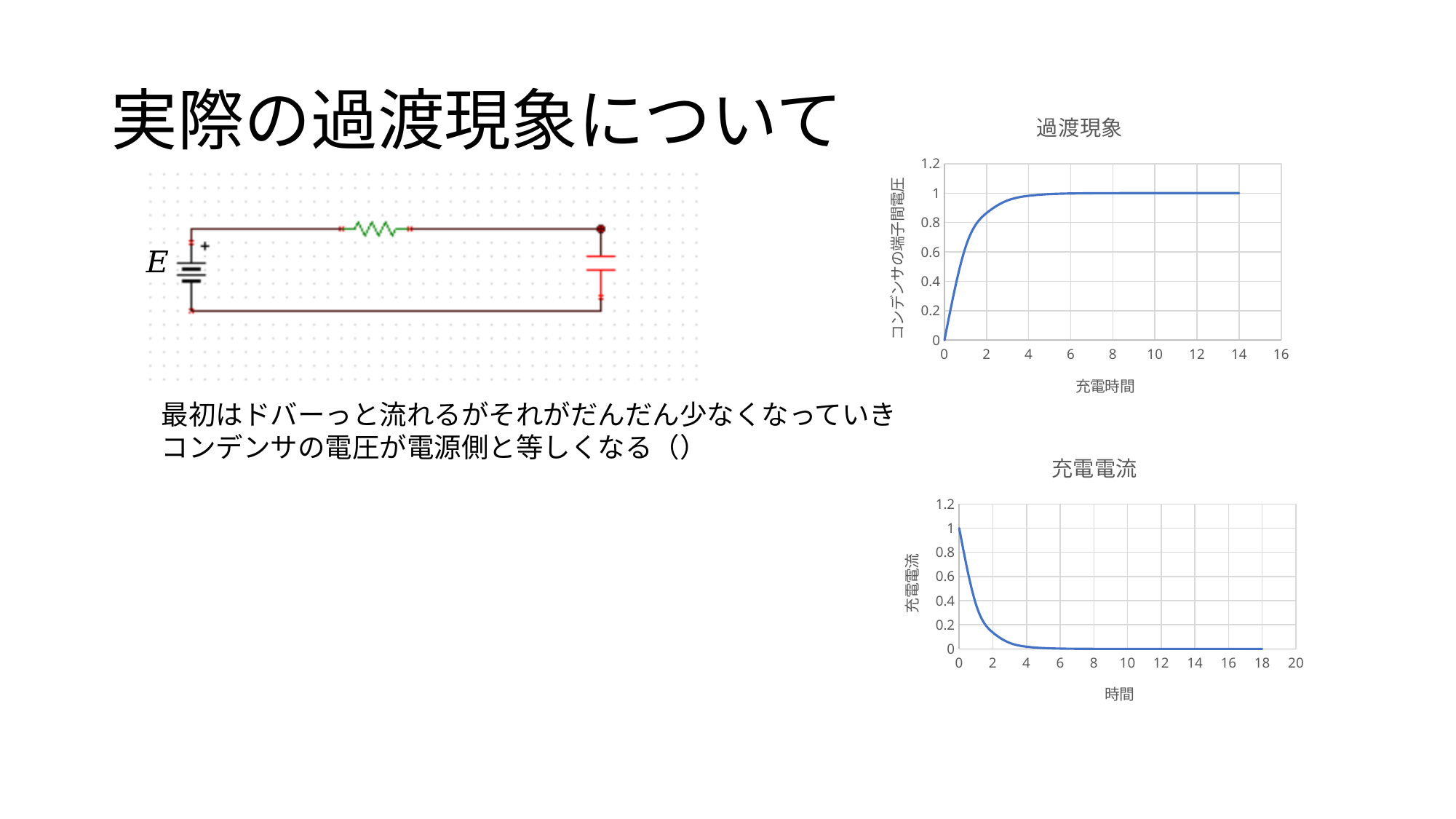
In the top chart 過渡現象, is the value at 充電時間 = 0.5 greater or less than 0.8? less In the top chart 過渡現象, which is larger: the value at 充電時間 = 1 or the value at 充電時間 = 6? 充電時間 = 6 In the bottom chart 充電電流, do the values rise or fall as 時間 increases? fall In the top chart 過渡現象, is the value at 充電時間 = 2 greater or less than 0.8? greater What kind of chart is the bottom chart titled 充電電流? line chart In the bottom chart 充電電流, is the value at 時間 = 6 greater or less than 0.2? less In the top chart 過渡現象, do the values rise or fall as 充電時間 increases? rise What is the title of the top chart on the slide? 過渡現象 What kind of chart is the top chart titled 過渡現象? line chart What is the x-axis label of the bottom chart 充電電流? 時間